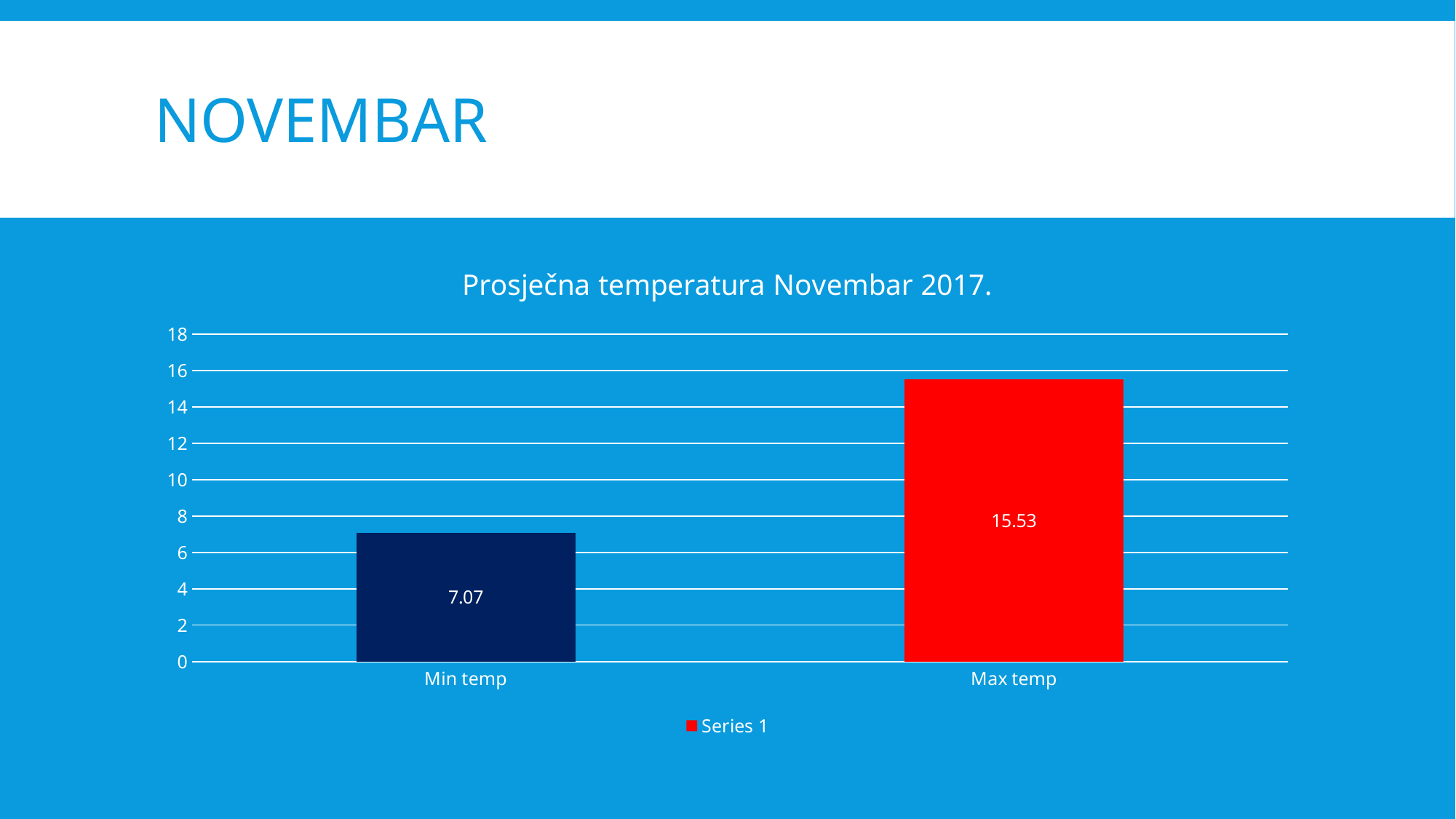
What is the value for Min temp? 7.07 Which category has the highest value? Max temp Is the value for Min temp greater or less than 8? less What kind of chart is shown on the slide? Bar chart Is the value for Max temp greater or less than 14? greater How many categories are shown on the x axis? 2 How many series does the legend list? 1 Which category has the lowest value? Min temp What is the value for Max temp? 15.53 Which is larger, the value for Min temp or the value for Max temp? Max temp What is the title of the chart? Prosječna temperatura Novembar 2017. What is the difference between the Max temp and Min temp values? 8.46